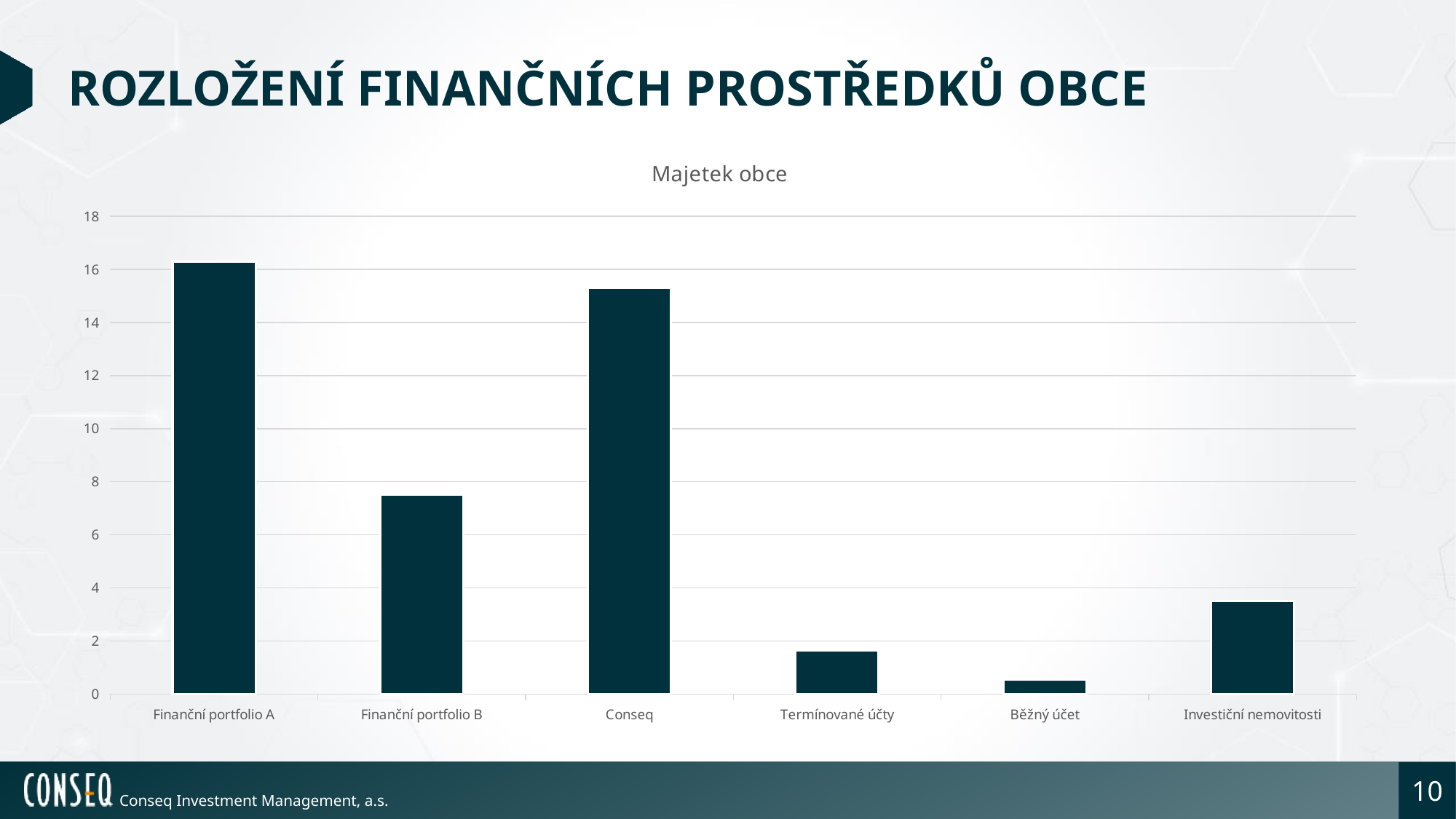
Is the value for Termínované účty greater or less than 2? less Is the value for Conseq greater or less than 14? greater Is the value for Finanční portfolio B greater or less than 8? less Which is larger, the value for Termínované účty or the value for Běžný účet? Termínované účty Which is larger, the value for Finanční portfolio B or the value for Investiční nemovitosti? Finanční portfolio B What kind of chart is shown on the slide? bar chart Which category has the lowest value in the chart? Běžný účet What is the title of the chart? Majetek obce How many categories are shown on the x axis of the chart? 6 Which category has the highest value in the chart? Finanční portfolio A